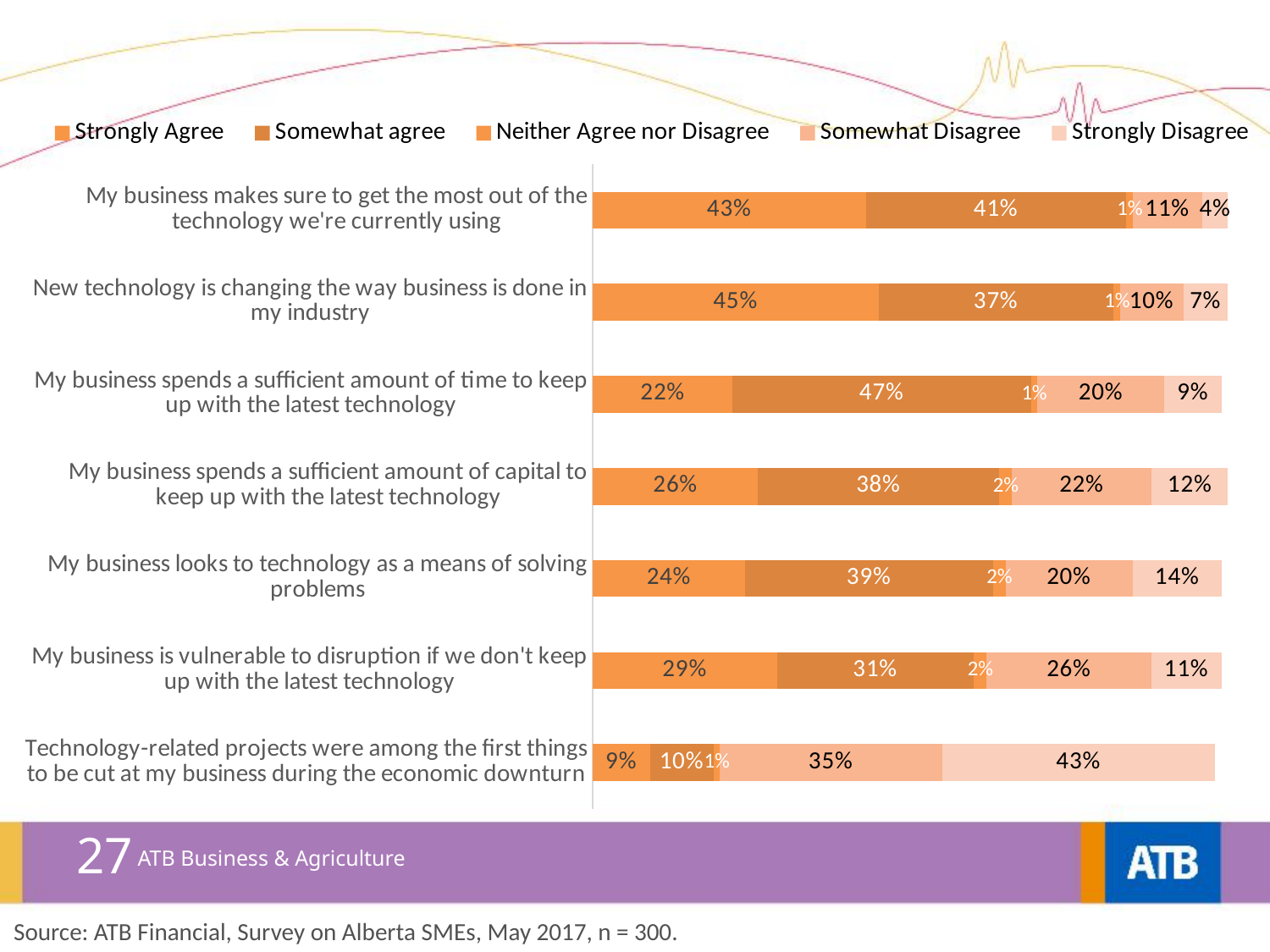
What is the Somewhat Disagree value for "My business is vulnerable to disruption if we don't keep up with the latest technology"? 26% What is the Somewhat agree value for "My business spends a sufficient amount of time to keep up with the latest technology"? 47% How many statements are shown in the chart? 7 What share of respondents strongly disagree that technology-related projects were among the first things to be cut during the economic downturn? 43% What kind of chart is shown on the slide? Stacked bar chart How many series does the legend list? 5 Which is larger for "My business looks to technology as a means of solving problems": the Somewhat Disagree value or the Strongly Disagree value? Somewhat Disagree Which statement has the highest Strongly Agree percentage? New technology is changing the way business is done in my industry What percentage of respondents strongly agree that new technology is changing the way business is done in their industry? 45% What is the difference between the Strongly Agree and Somewhat agree values for "My business spends a sufficient amount of capital to keep up with the latest technology"? 12% Which statement has the lowest Strongly Agree percentage? Technology-related projects were among the first things to be cut at my business during the economic downturn What is the combined Strongly Agree and Somewhat agree percentage for "My business makes sure to get the most out of the technology we're currently using"? 84%